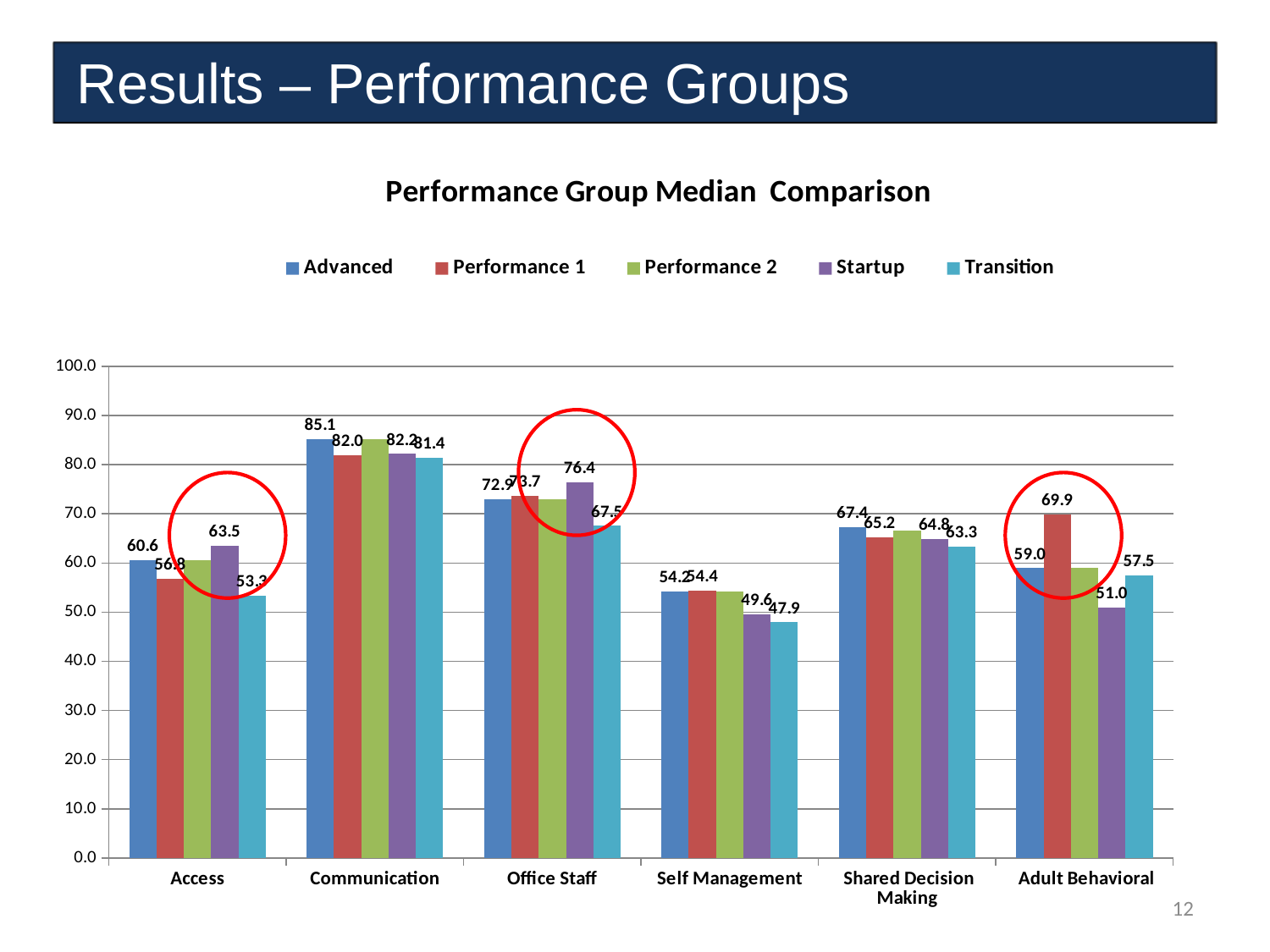
What is the Advanced value for Communication? 85.1 Is the Performance 2 value for Communication greater or less than 80? greater How many series does the legend list? 5 Which series has the lowest value for Self Management? Transition What kind of chart is shown on the slide? bar chart How many categories are shown along the x axis? 6 Which category has the highest Advanced value? Communication What is the Performance 1 value for Adult Behavioral? 69.9 What is the title of the chart? Performance Group Median Comparison For Adult Behavioral, which is larger: the Performance 1 value or the Startup value? Performance 1 What is the difference between the Startup and Transition values for Office Staff? 8.9 What is the Startup value for Access? 63.5